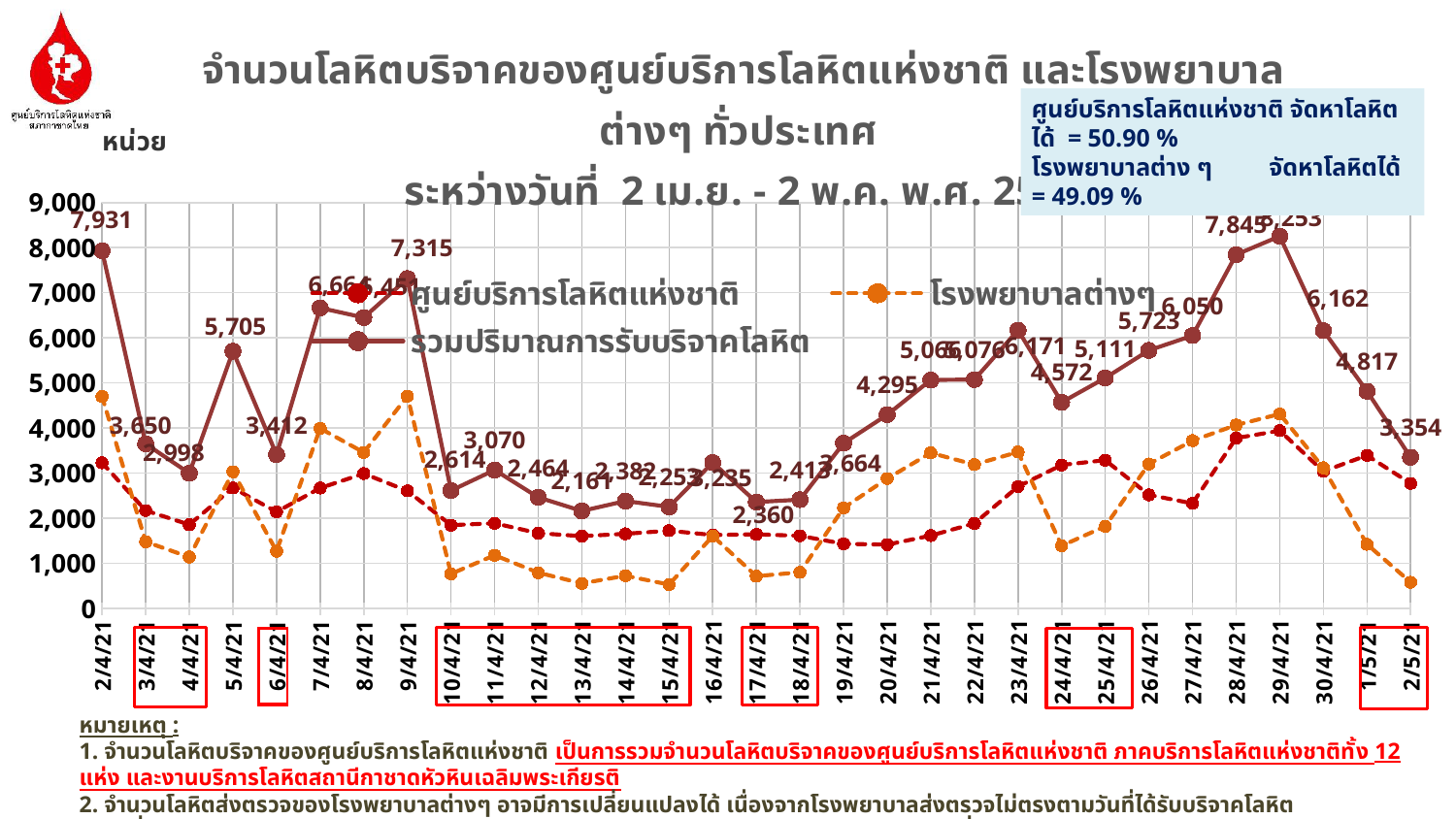
What is the value of รวมปริมาณการรับบริจาคโลหิต on 29/4/21? 8,253 Is the value for โรงพยาบาลต่างๆ on 2/5/21 greater or less than 1,000? less Does รวมปริมาณการรับบริจาคโลหิต rise or fall from 29/4/21 to 2/5/21? fall Which is larger for รวมปริมาณการรับบริจาคโลหิต: the value on 5/4/21 or the value on 9/4/21? 9/4/21 What is the value of รวมปริมาณการรับบริจาคโลหิต on 13/4/21? 2,161 On which date is รวมปริมาณการรับบริจาคโลหิต highest? 29/4/21 How many dates are plotted along the x axis of the chart? 31 What is the difference between รวมปริมาณการรับบริจาคโลหิต on 28/4/21 (7,845) and on 30/4/21 (6,162)? 1,683 What type of chart is shown on the slide? line chart What is the value of รวมปริมาณการรับบริจาคโลหิต on 2/4/21? 7,931 On which date is รวมปริมาณการรับบริจาคโลหิต lowest? 13/4/21 How many series does the chart legend list? 3